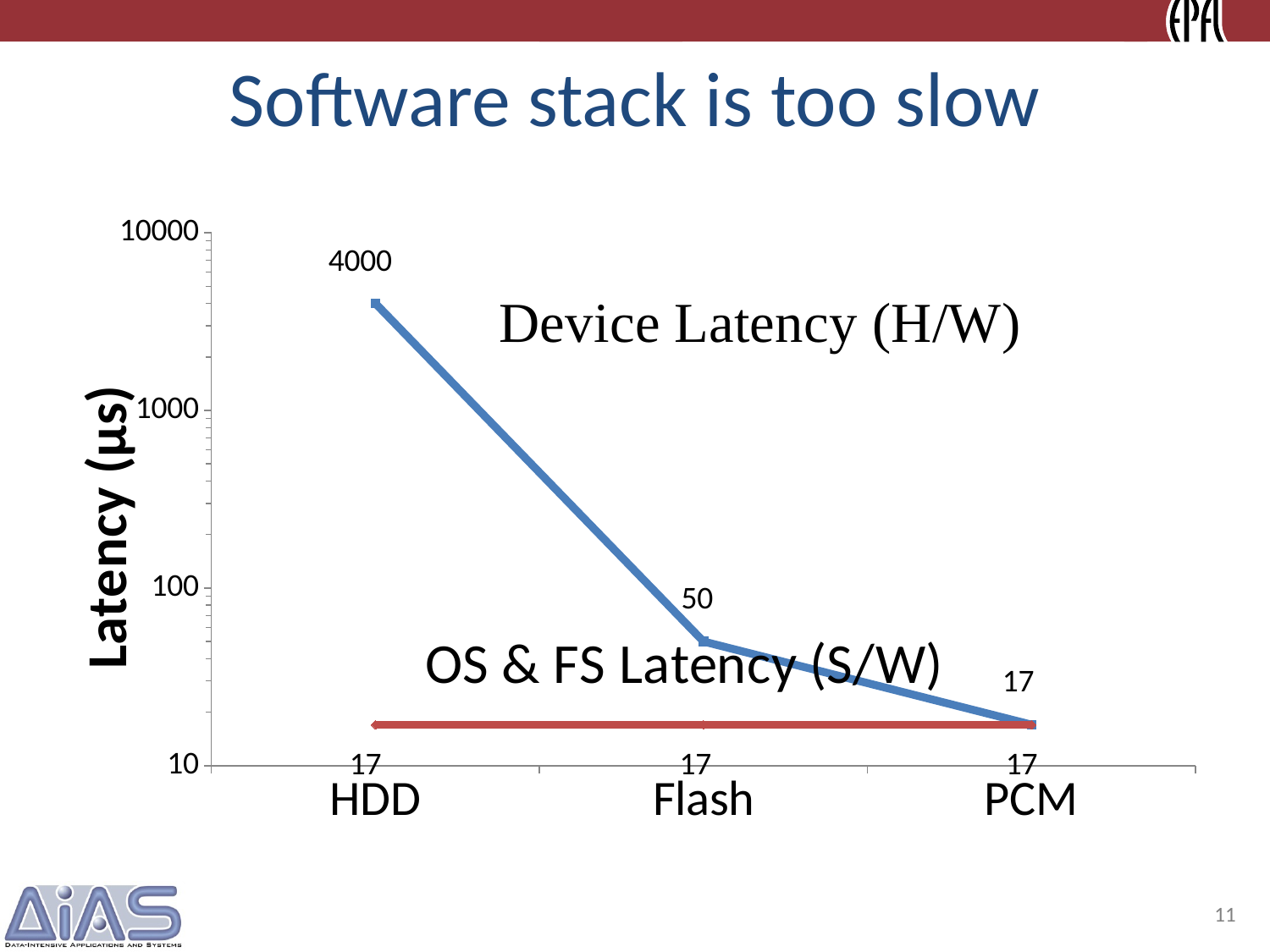
Is the Device Latency (H/W) value for HDD greater or less than 1000? greater Does the Device Latency (H/W) series rise or fall from HDD to PCM? fall How many device categories are shown on the x axis? 3 Which is larger, the Device Latency (H/W) for Flash or the OS & FS Latency (S/W) for Flash? Device Latency (H/W) for Flash What is the Device Latency (H/W) value for PCM? 17 What kind of chart is shown on the slide? line chart What is the Device Latency (H/W) value for Flash? 50 What is the OS & FS Latency (S/W) value for Flash? 17 What is the Device Latency (H/W) value for HDD? 4000 Which device has the highest Device Latency (H/W)? HDD What is the difference between the Device Latency (H/W) for HDD and for Flash? 3950 Which device has the lowest Device Latency (H/W)? PCM